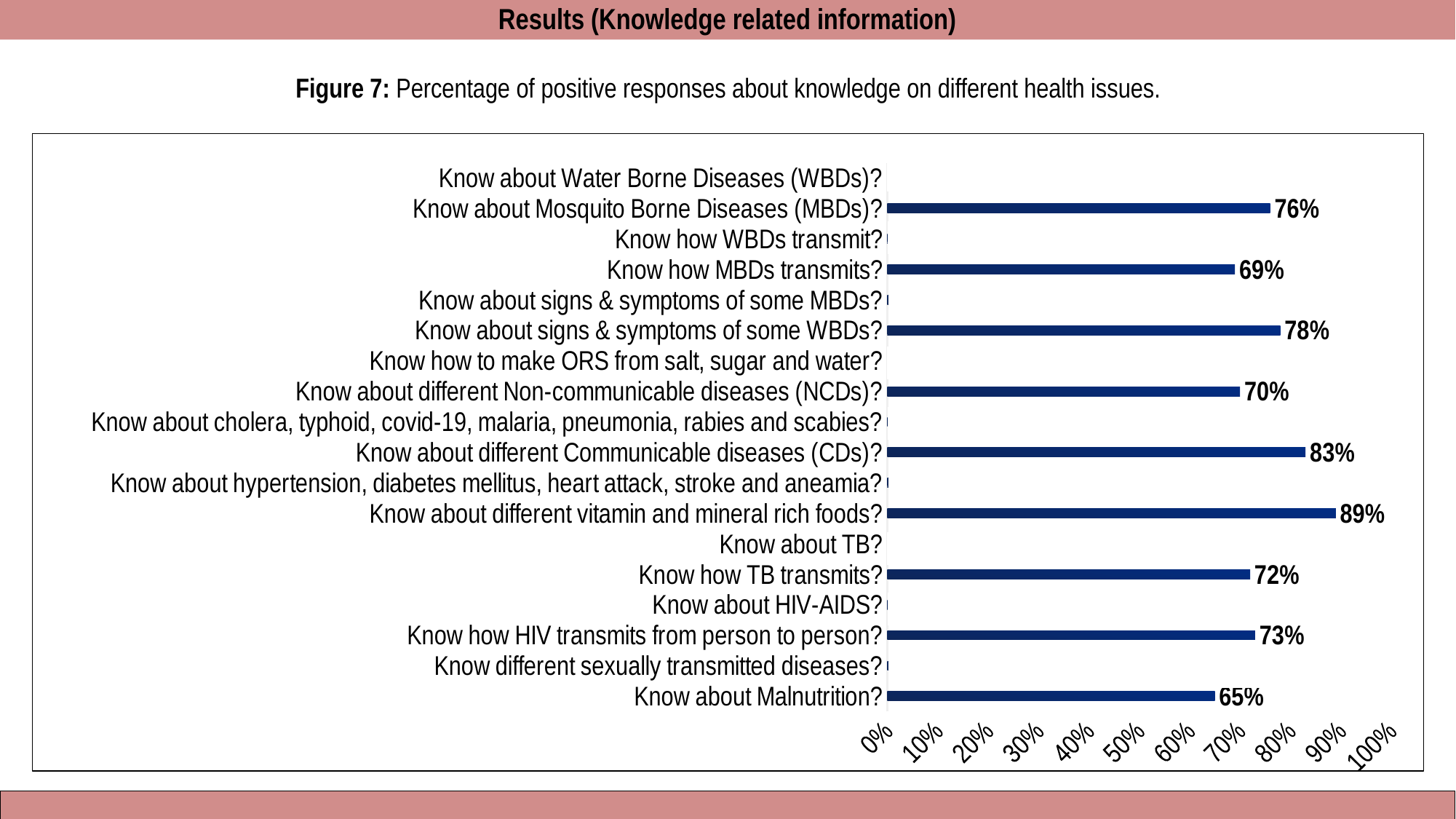
What is the percentage of positive responses for "Know about Malnutrition?" 65% What kind of chart is shown on the slide? Bar chart What is the percentage of positive responses for "Know how TB transmits?" 72% Among the bars with printed values, which category has the lowest percentage? Know about Malnutrition? What is the figure number and caption of the chart? Figure 7: Percentage of positive responses about knowledge on different health issues. Which is larger: the percentage for "Know about Mosquito Borne Diseases (MBDs)?" or for "Know about signs & symptoms of some WBDs?" Know about signs & symptoms of some WBDs? What is the percentage of positive responses for "Know about different Communicable diseases (CDs)?" 83% Which category has the highest percentage of positive responses? Know about different vitamin and mineral rich foods? Is the value for "Know about different Communicable diseases (CDs)?" greater or less than 80%? greater What is the difference between the percentage for "Know about different vitamin and mineral rich foods?" and "Know about Malnutrition?" 24 percentage points What is the percentage of positive responses for "Know about different vitamin and mineral rich foods?" 89% How many category labels are listed on the vertical axis of the chart? 18